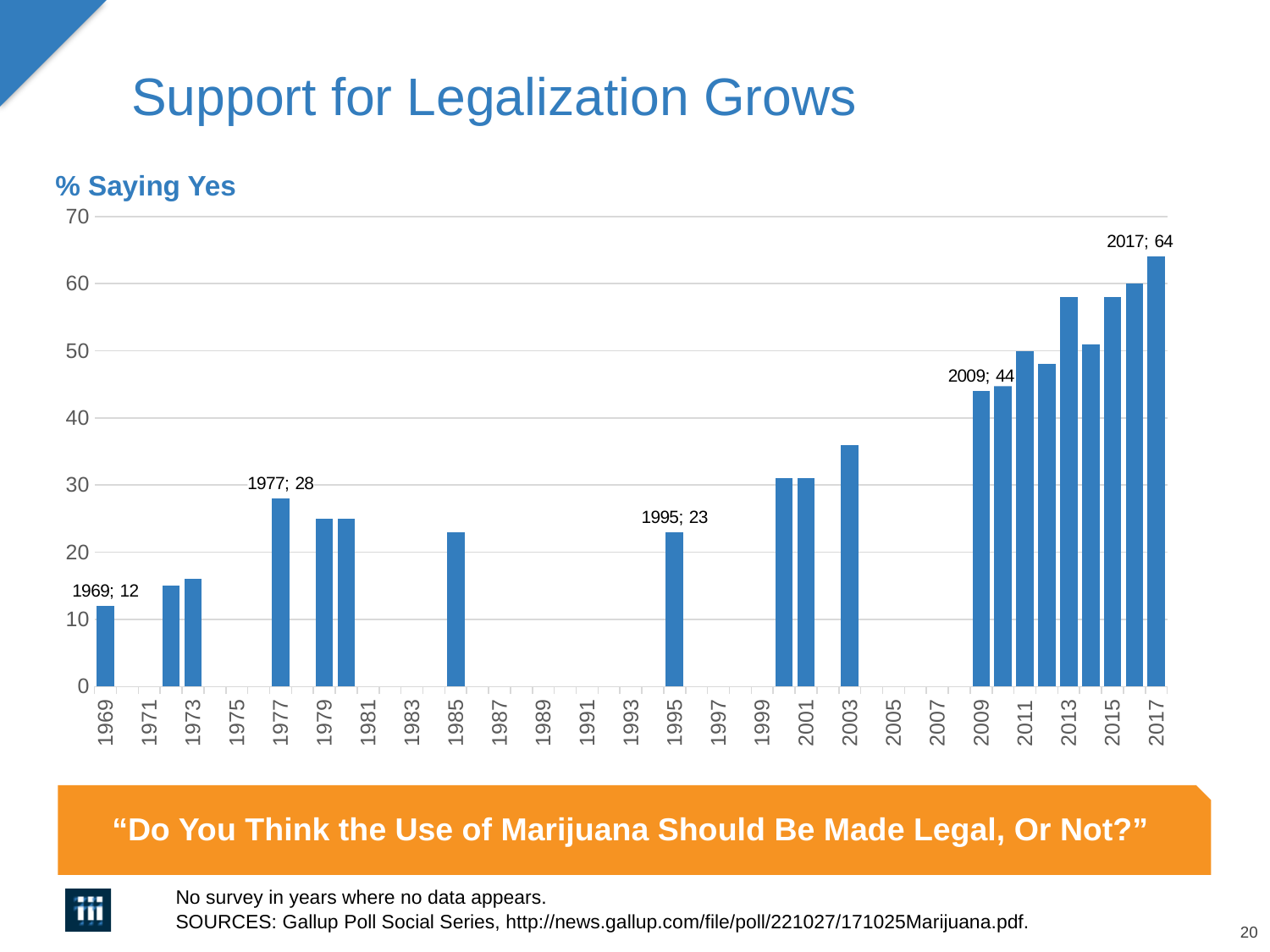
Which year has the lowest percentage saying yes? 1969 What percentage said yes in 2017? 64 What is the difference between the 2017 value and the 2009 value? 20 By how many points did the percentage saying yes increase from 1969 to 2017? 52 Which year had a higher percentage saying yes, 1977 or 1995? 1977 What value is shown for 1995? 23 What percentage said yes in 1969? 12 What kind of chart is shown on the slide? bar chart What percentage said yes in 1977? 28 Is the value for 2003 greater or less than 30? greater What value is shown for 2009? 44 Which year has the highest percentage saying yes? 2017